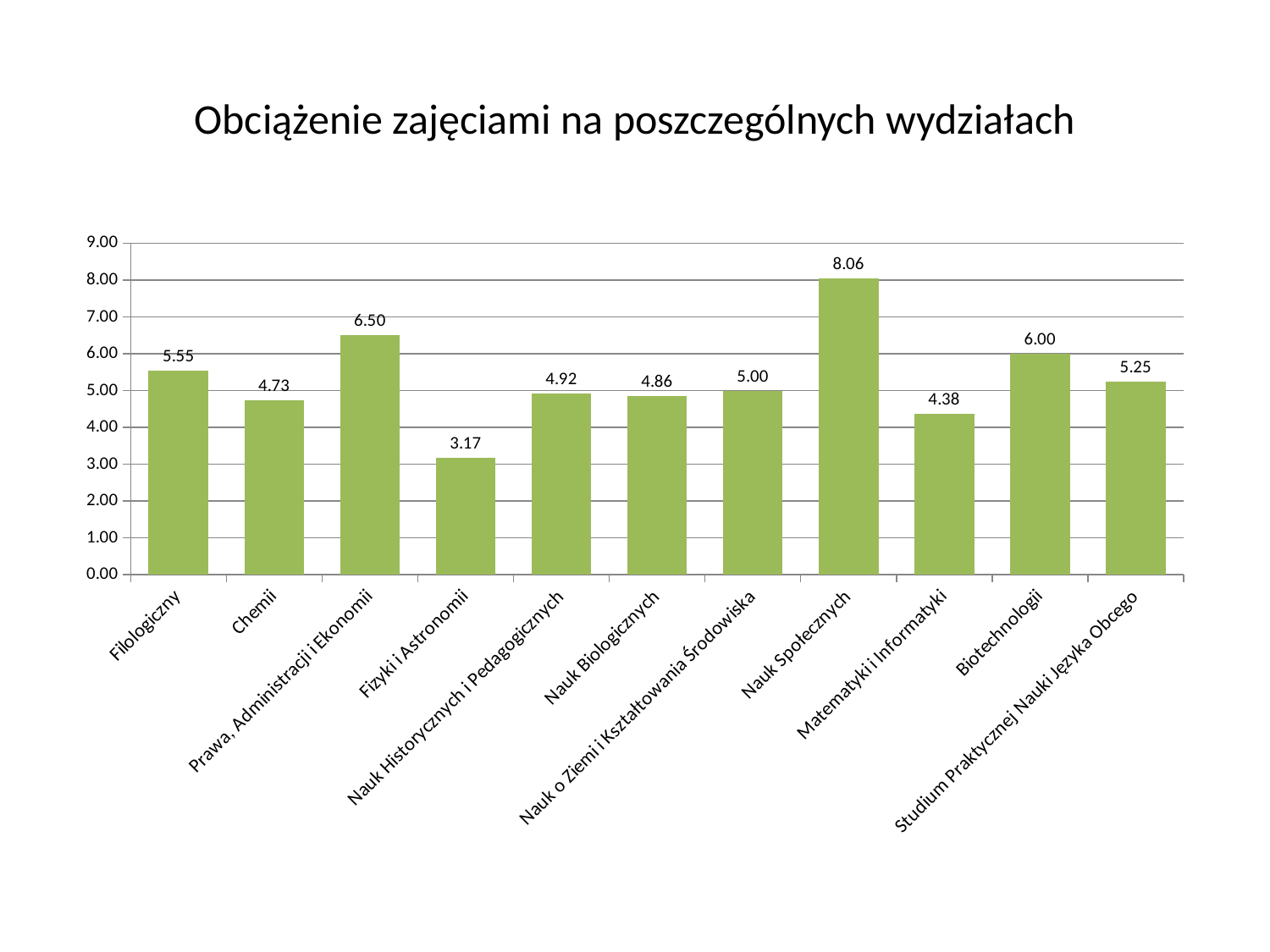
How many categories are shown on the x axis? 11 Which is larger, the value for Filologiczny or the value for Studium Praktycznej Nauki Języka Obcego? Filologiczny What is the value for Nauk Społecznych? 8.06 Is the value for Matematyki i Informatyki greater or less than 5.00? less What is the value for Biotechnologii? 6.00 What kind of chart is shown on the slide? bar chart What is the title of the slide? Obciążenie zajęciami na poszczególnych wydziałach Which category has the highest value? Nauk Społecznych What is the value for Fizyki i Astronomii? 3.17 What is the difference between the values for Nauk Społecznych and Fizyki i Astronomii? 4.89 What is the difference between the values for Prawa, Administracji i Ekonomii and Chemii? 1.77 Which category has the lowest value? Fizyki i Astronomii